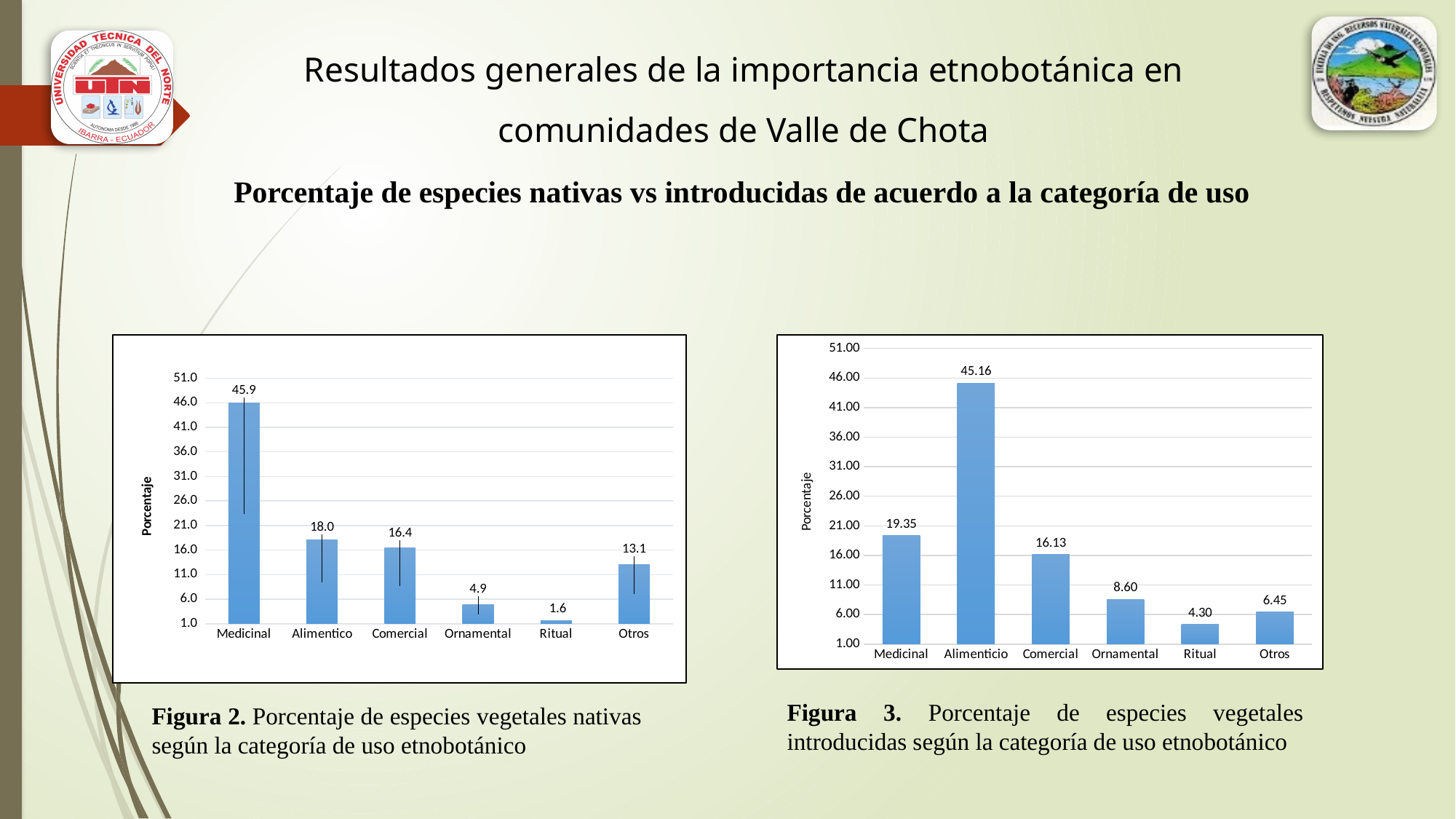
In the left chart (Figura 2, native species), what is the value for Medicinal? 45.9 In the left chart (Figura 2, native species), which category has the highest value? Medicinal In the left chart (Figura 2, native species), what is the value for Ritual? 1.6 What is the y-axis label of the right chart (Figura 3)? Porcentaje In the right chart (Figura 3, introduced species), what is the value for Ornamental? 8.60 In the left chart (Figura 2, native species), how many categories are shown on the x axis? 6 In the right chart (Figura 3, introduced species), which category has the lowest value? Ritual In the right chart (Figura 3, introduced species), what is the difference between Medicinal and Comercial? 3.22 What kind of chart is the right chart (Figura 3)? Bar chart In the left chart (Figura 2, native species), what is the difference between Comercial and Ornamental? 11.5 In the right chart (Figura 3, introduced species), what is the value for Alimenticio? 45.16 In the left chart (Figura 2, native species), which is larger, Alimentico or Otros? Alimentico